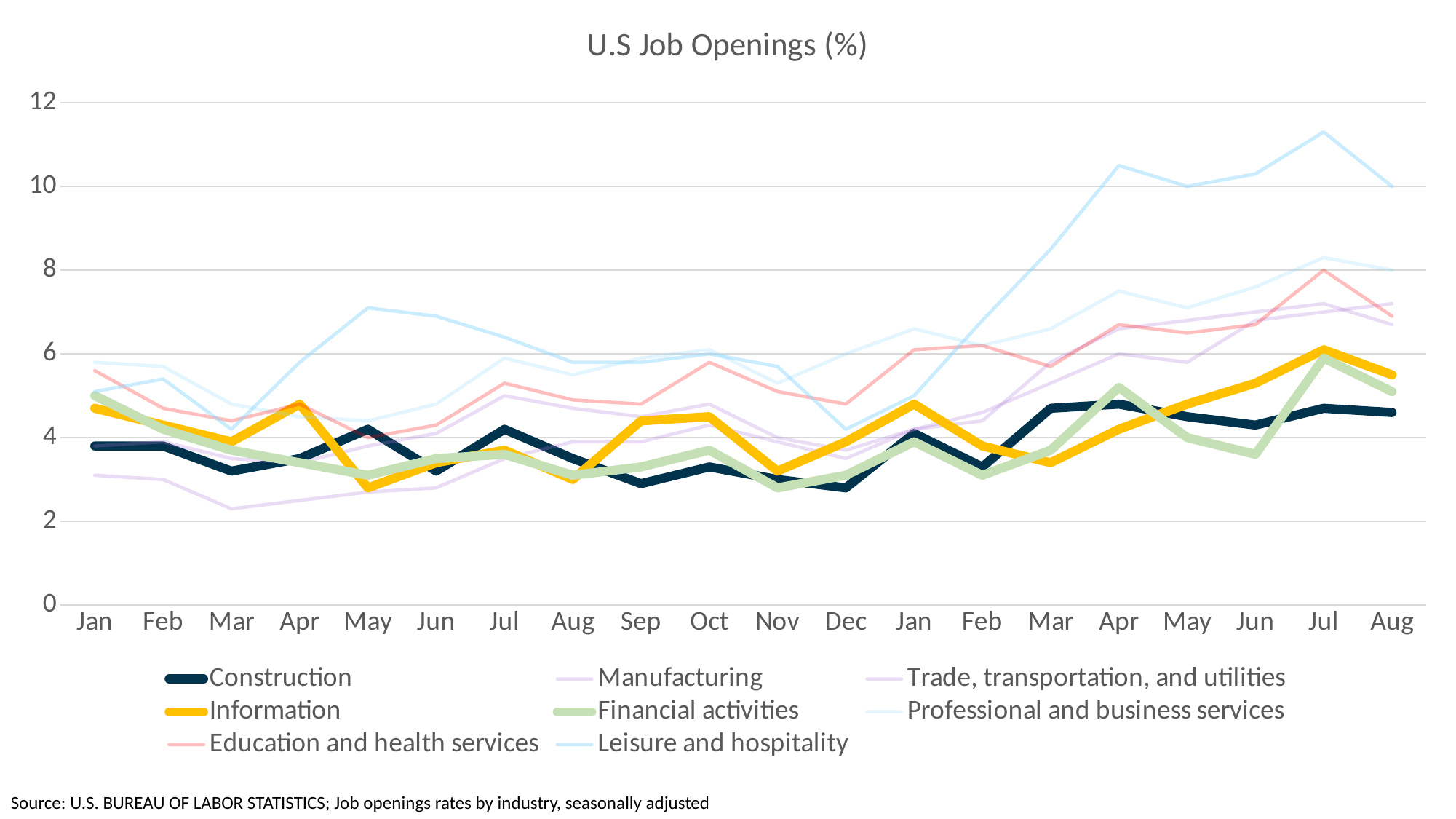
How many months are shown along the x axis? 20 Is the value for Information in the first May greater or less than 4? less What is the title of the chart? U.S Job Openings (%) What kind of chart is shown on the slide? line chart Is the value for Information in the second Aug greater or less than 5? greater Is the value for Financial activities in the first Nov greater or less than 4? less In the second Jul, which is larger, Construction or Information? Information In the first May, which is larger, Construction or Information? Construction Does the Information line rise or fall from the second Mar to the second Jul? rise How many series does the legend list? 8